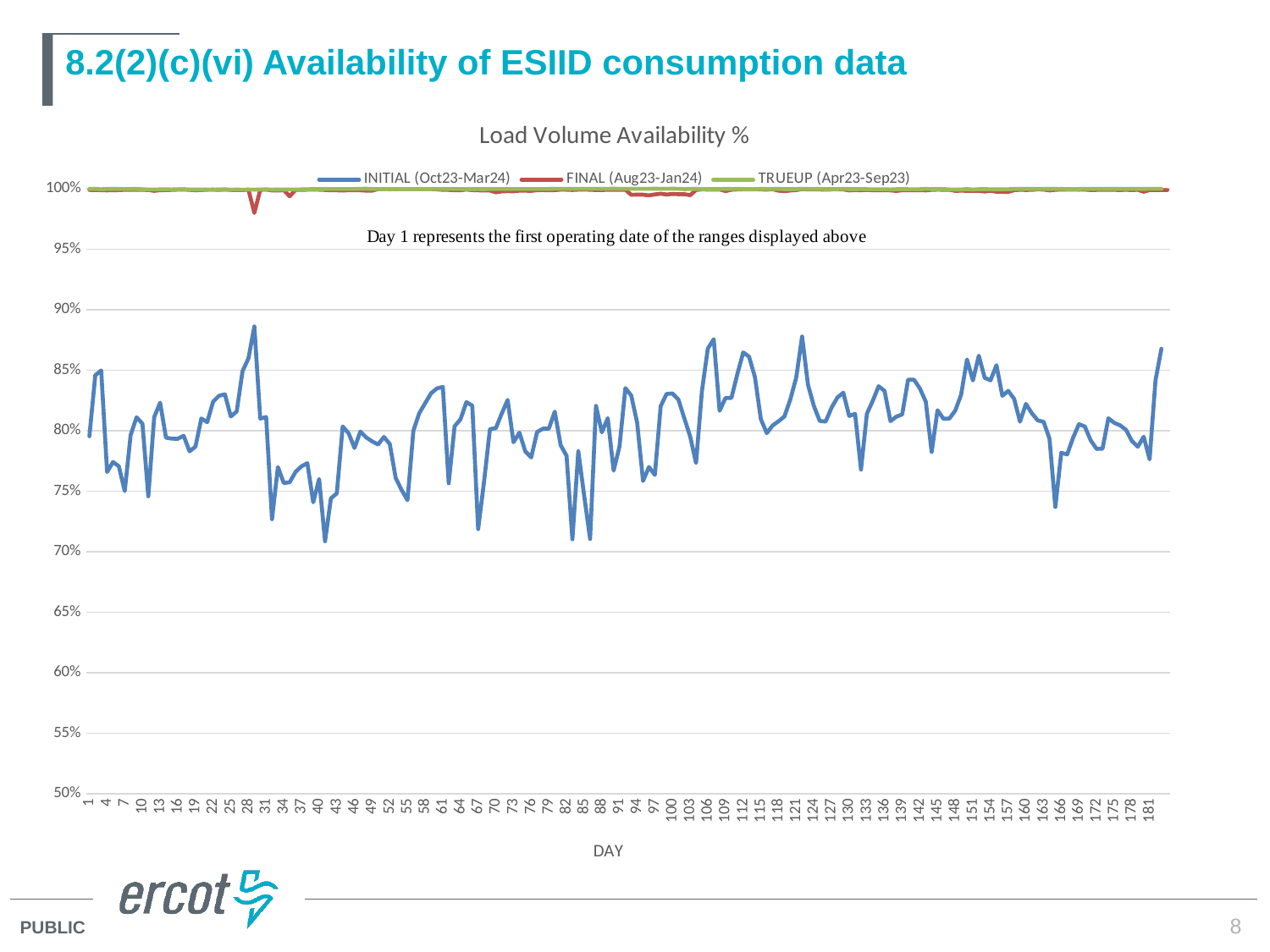
What kind of chart is shown on the slide? line chart Is the value for INITIAL (Oct23-Mar24) at day 1 greater or less than 75%? greater Is the value for INITIAL (Oct23-Mar24) at day 40 greater or less than 75%? greater What is the title of the chart? Load Volume Availability % What is the label of the x axis? DAY Is the value for FINAL (Aug23-Jan24) at day 100 greater or less than 95%? greater Which series is larger at day 1, INITIAL (Oct23-Mar24) or FINAL (Aug23-Jan24)? FINAL (Aug23-Jan24) How many series does the legend list? 3 Which series has the lowest values across the chart? INITIAL (Oct23-Mar24)